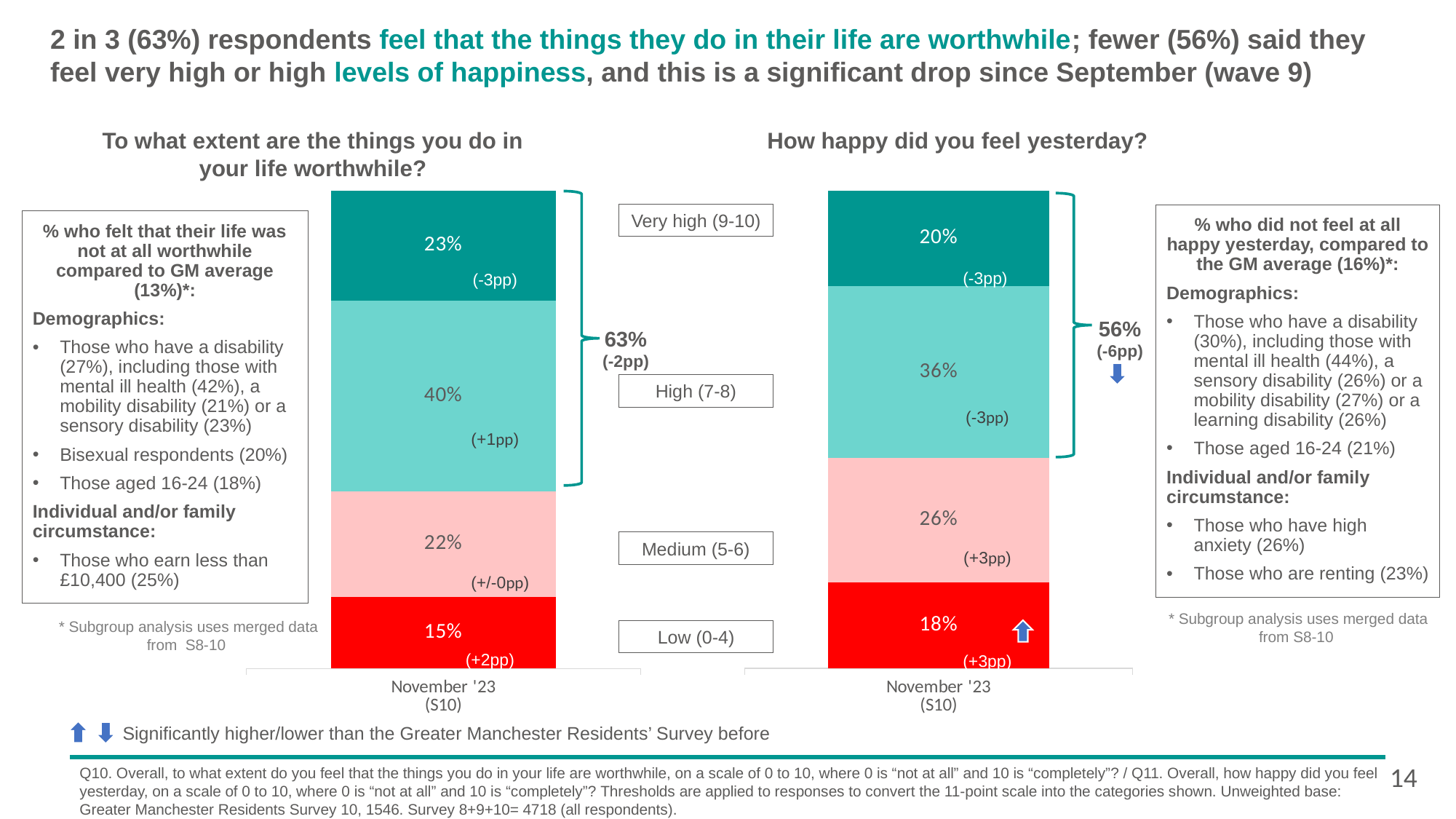
What type of chart is used for "To what extent are the things you do in your life worthwhile?" Stacked bar chart In the chart titled "How happy did you feel yesterday?", what is the difference between the Very high (9-10) and Low (0-4) percentages? 2 percentage points In the chart titled "How happy did you feel yesterday?", what percentage of respondents are in the High (7-8) category? 36% In the chart titled "How happy did you feel yesterday?", what is the combined percentage for Very high (9-10) and High (7-8)? 56% In the chart titled "To what extent are the things you do in your life worthwhile?", which category has the largest share? High (7-8) In the chart titled "To what extent are the things you do in your life worthwhile?", what is the difference between the High (7-8) and Medium (5-6) percentages? 18 percentage points How many categories are stacked in the bar of the chart titled "How happy did you feel yesterday?" 4 In the chart titled "How happy did you feel yesterday?", which category has the smallest share? Low (0-4) In the chart titled "To what extent are the things you do in your life worthwhile?", what is the combined percentage for Very high (9-10) and High (7-8)? 63% In the chart titled "To what extent are the things you do in your life worthwhile?", what percentage of respondents are in the Very high (9-10) category? 23% Which chart has the larger Medium (5-6) share: "To what extent are the things you do in your life worthwhile?" or "How happy did you feel yesterday?" How happy did you feel yesterday? In the chart titled "How happy did you feel yesterday?", what percentage of respondents are in the Low (0-4) category? 18%